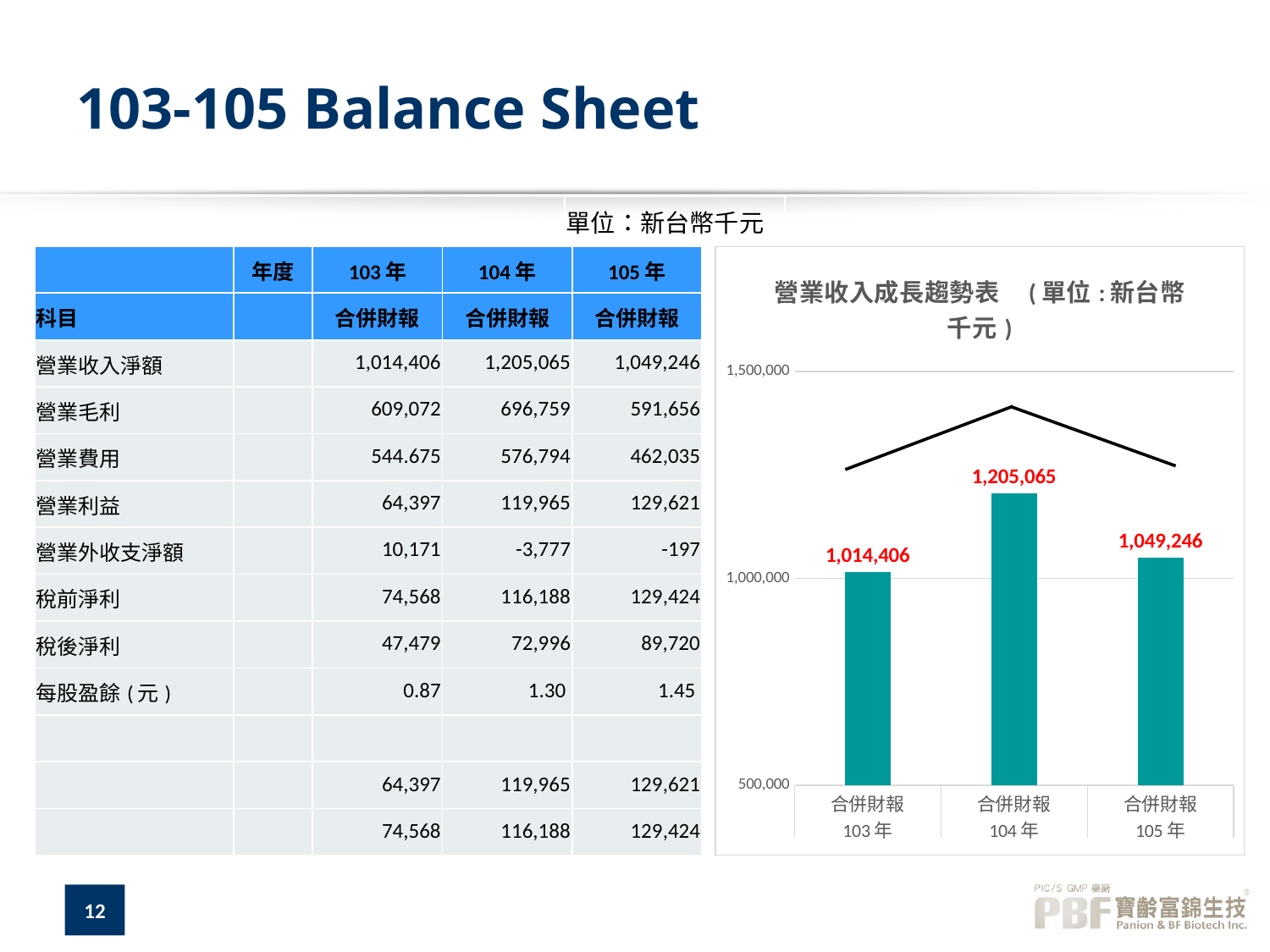
What is the value shown for 103 年 in the chart? 1,014,406 Is the value for 104 年 in the chart greater or less than 1,500,000? less What is the value shown for 105 年 in the chart? 1,049,246 What is the title of the chart on the slide? 營業收入成長趨勢表 (單位:新台幣千元) How many bars are plotted in the chart? 3 What kind of chart is shown on the slide? bar chart What is the difference between the values for 104 年 and 103 年 in the chart? 190,659 What is the difference between the values for 104 年 and 105 年 in the chart? 155,819 Which is larger in the chart, the value for 105 年 or the value for 103 年? 105 年 Which year has the lowest value in the chart? 103 年 Which year has the highest value in the chart? 104 年 What is the value shown for 104 年 in the chart? 1,205,065